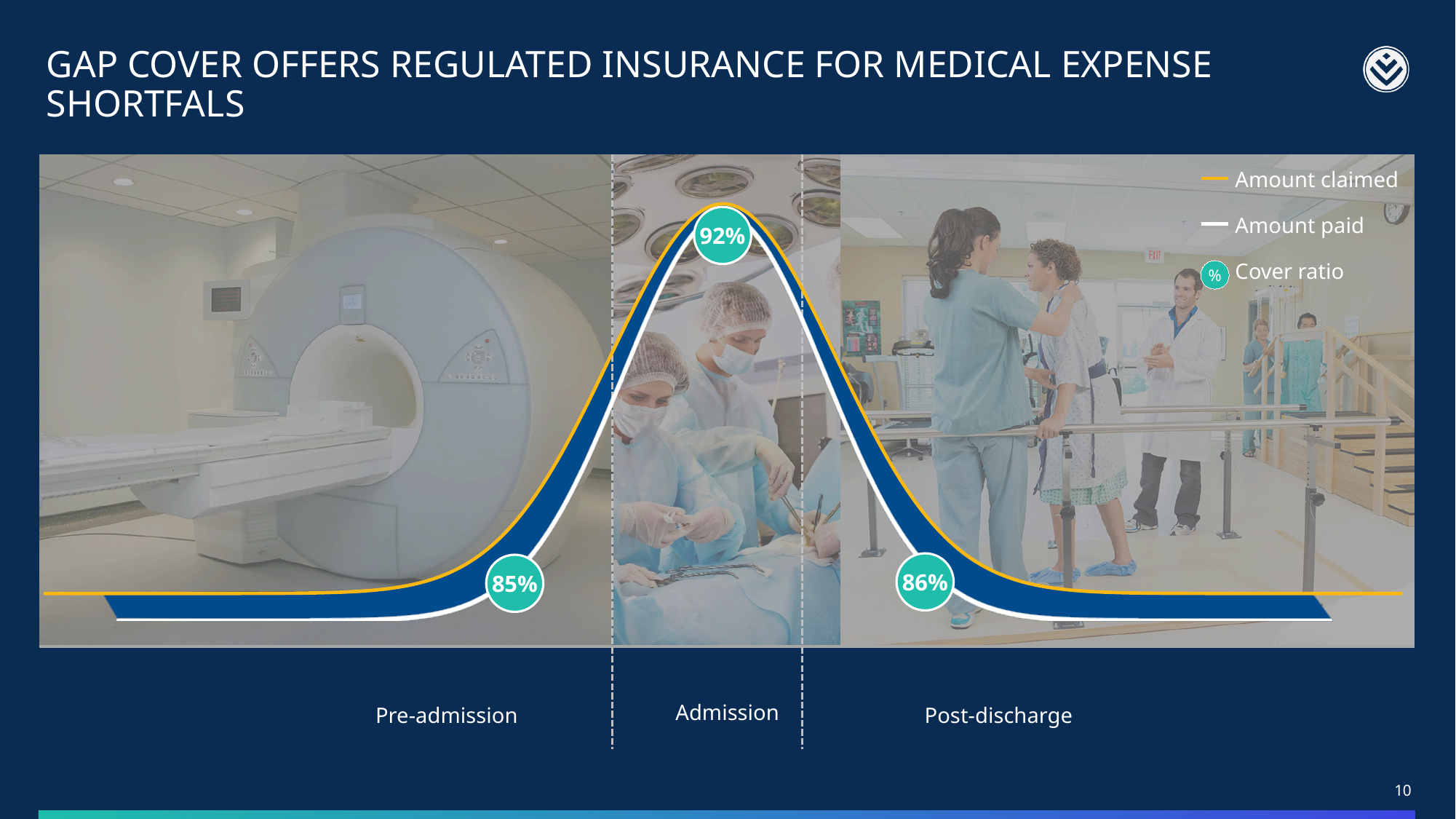
What is the cover ratio shown for the Admission phase? 92% How do the Amount claimed and Amount paid lines move from Pre-admission through Admission to Post-discharge? They rise to a peak at Admission, then fall What kind of chart is shown on the slide? Line chart Which phase has the lowest cover ratio? Pre-admission Which phase has the highest cover ratio? Admission How many entries does the legend list? 3 What is the difference in percentage points between the Admission cover ratio and the Pre-admission cover ratio? 7 percentage points How many phases are labelled along the bottom of the chart? 3 What is the cover ratio shown for the Post-discharge phase? 86% Which colour represents Amount claimed in the legend? Orange Which is larger, the cover ratio for Post-discharge or for Pre-admission? Post-discharge What is the cover ratio shown for the Pre-admission phase? 85%